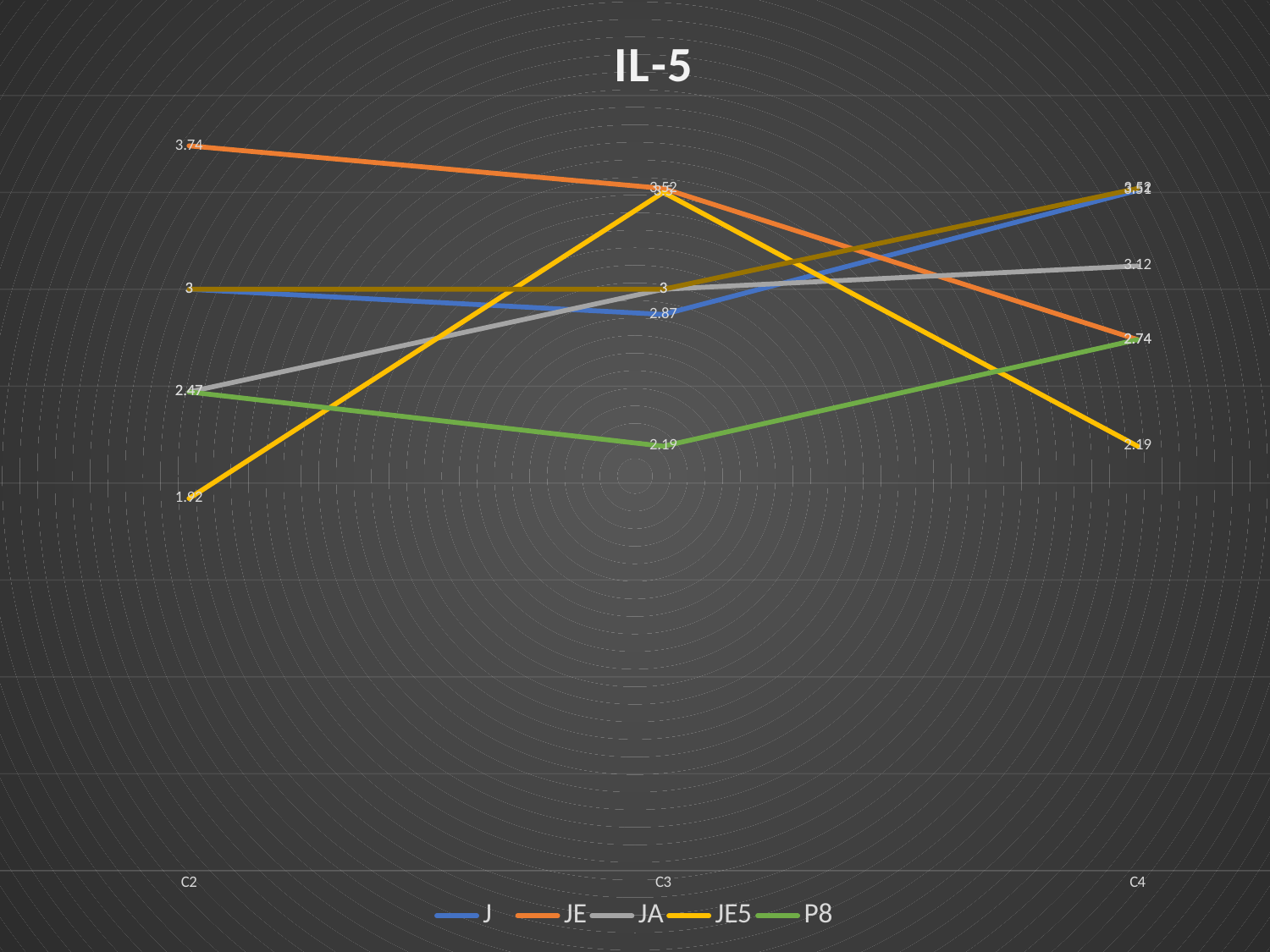
What is the value for P8 at C3? 2.19 What is the value for JE5 at C2? 1.92 What is the value for JA at C4? 3.12 What is the title of the chart? IL-5 What kind of chart is shown on the slide? line chart Which series has the lowest value at C2? JE5 How many series does the legend list? 5 What is the value for J at C3? 2.87 What is the value for JE at C2? 3.74 What is the difference between the JE value at C2 and the JE value at C4? 1 How many categories are shown on the x axis? 3 Which series has the highest value at C2? JE